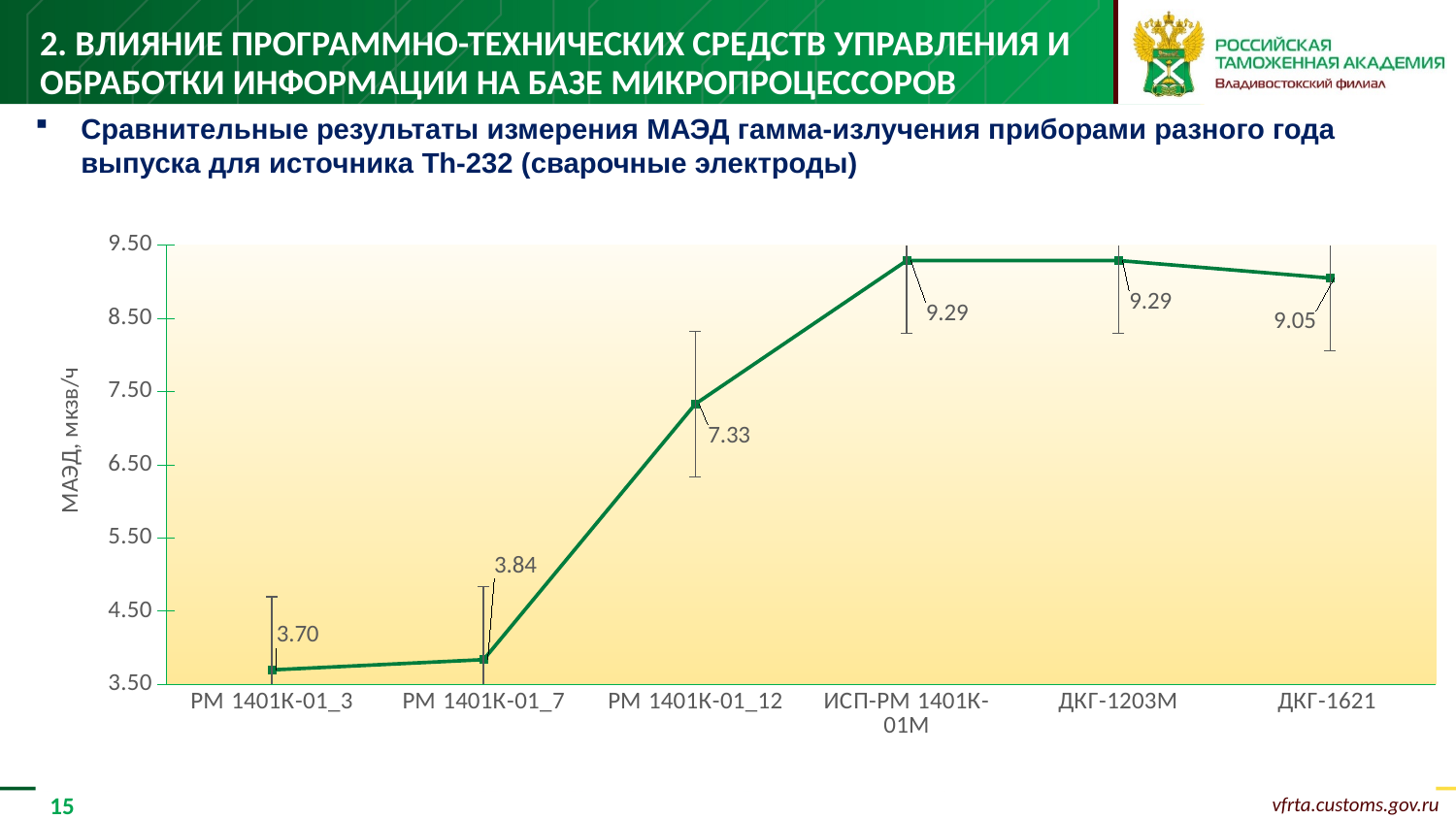
Which device has the lowest value? РМ 1401К-01_3 What is the value for ДКГ-1621? 9.05 What kind of chart is this? line chart What is the difference between the values for РМ 1401К-01_12 and РМ 1401К-01_3? 3.63 What is the value for РМ 1401К-01_7? 3.84 What is the label of the y axis? МАЭД, мкЗв/ч What is the value for ИСП-РМ 1401К-01М? 9.29 How many devices are shown on the x axis? 6 Is the value for РМ 1401К-01_12 greater or less than 6.50? greater What is the difference between the values for ДКГ-1203М and ДКГ-1621? 0.24 Which is larger, the value for РМ 1401К-01_12 or the value for ДКГ-1621? ДКГ-1621 What is the value for РМ 1401К-01_12? 7.33